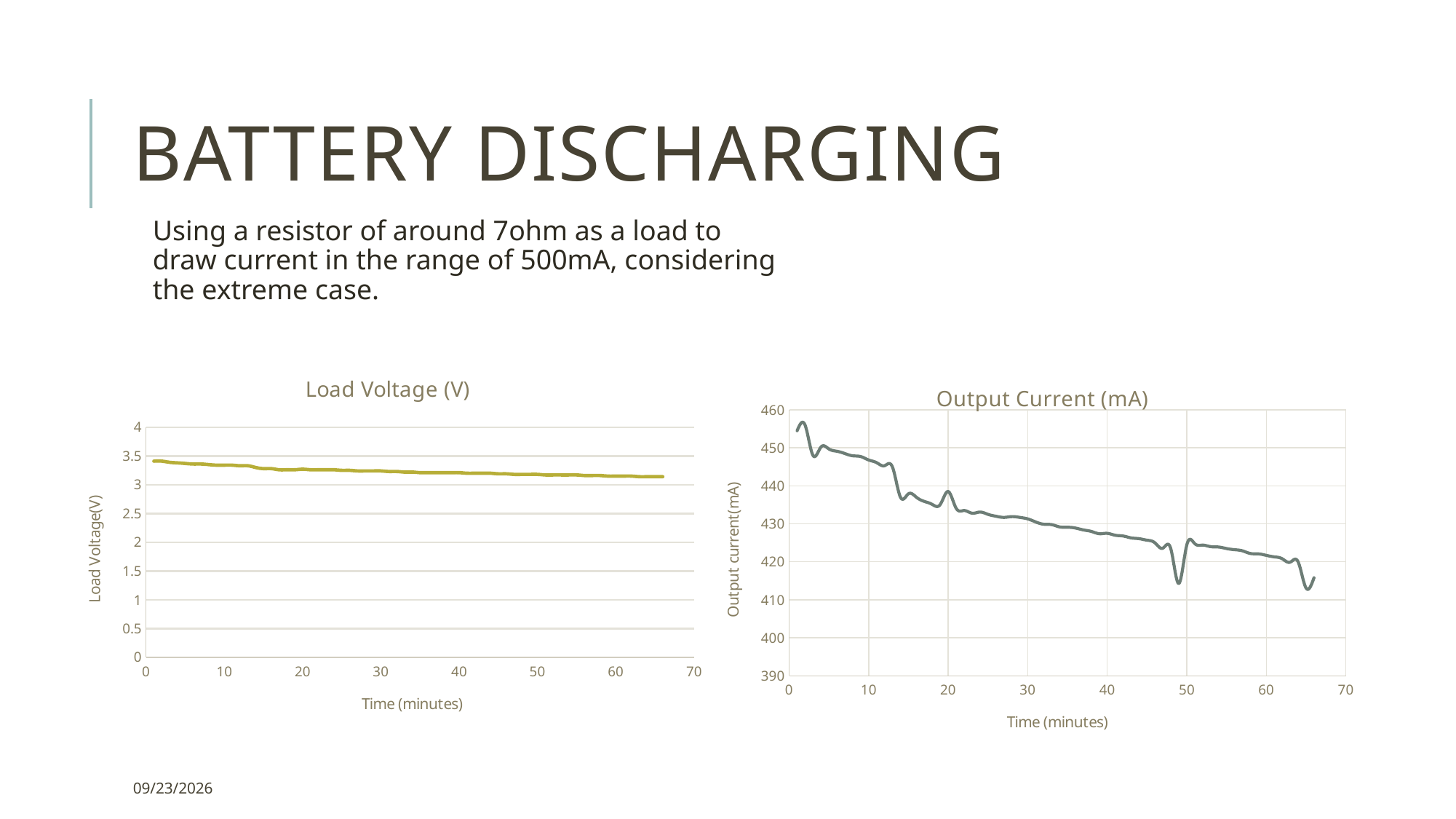
In the Output Current (mA) chart, is the value at 60 minutes greater or less than 430? less In the Load Voltage (V) chart, is the value at 10 minutes greater or less than 3? greater In the Output Current (mA) chart, is the value at 30 minutes greater or less than 420? greater In the Load Voltage (V) chart, do the values rise or fall as time increases? fall What kind of chart is the Output Current (mA) chart? line chart What is the x-axis label of the Load Voltage (V) chart? Time (minutes) In the Output Current (mA) chart, do the values rise or fall as time increases? fall What is the y-axis label of the Output Current (mA) chart? Output current(mA) What kind of chart is the Load Voltage (V) chart? line chart